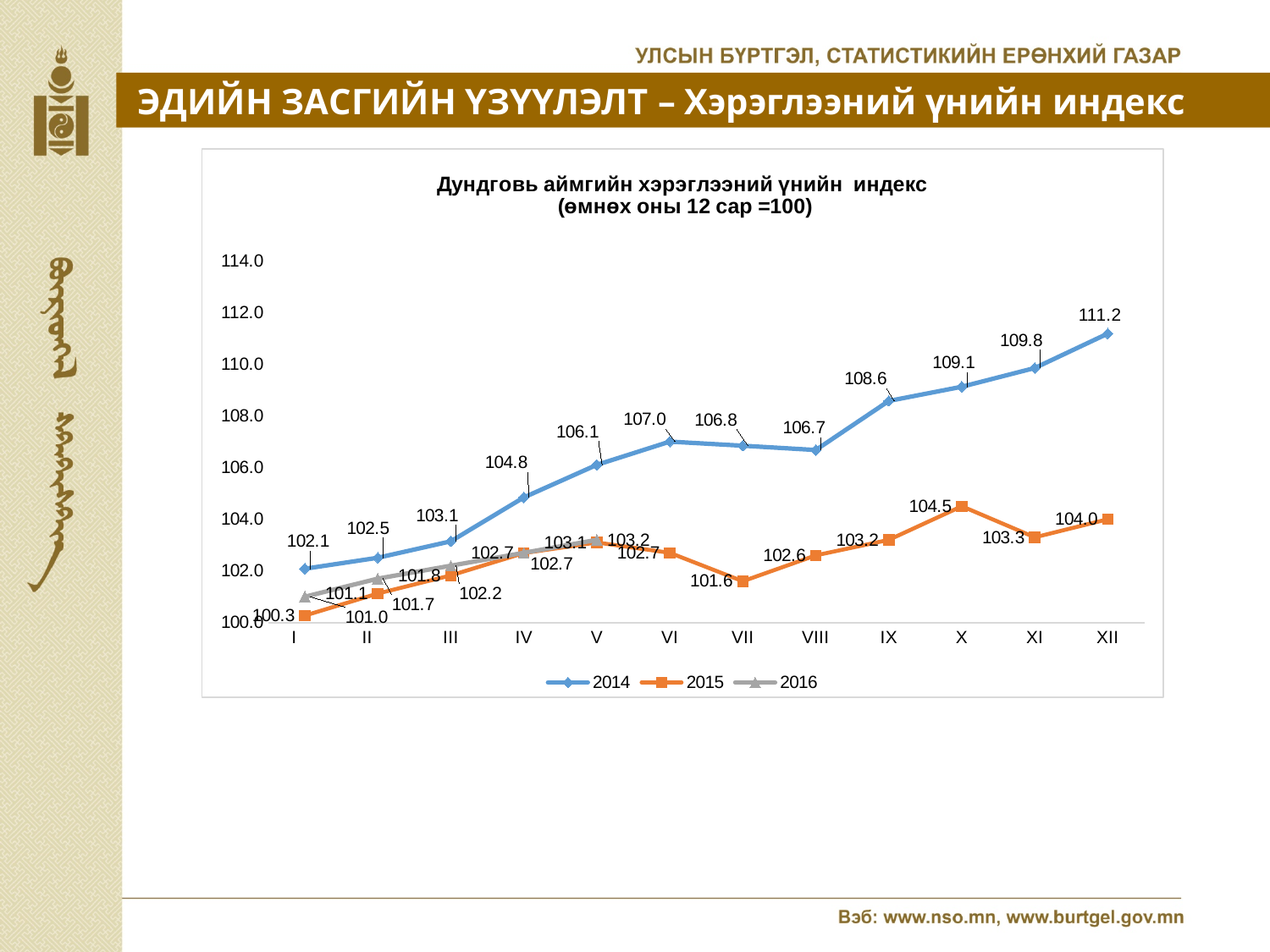
In which month is the 2015 series at its lowest value? I What kind of chart is shown on the slide? Line chart In which month does the 2014 series reach its highest value? XII How many months are shown on the x axis? 12 Is the value of the 2014 series in month V greater or less than 104.0? greater What is the value of the 2015 series in month VII? 101.6 How many series does the legend list? 3 What is the value of the 2015 series in month X? 104.5 In month XII, which series has the larger value, 2014 or 2015? 2014 What is the difference between the 2014 value in month XII and the 2014 value in month I? 9.1 What is the value of the 2014 series in month IX? 108.6 What is the value of the 2014 series in month XII? 111.2